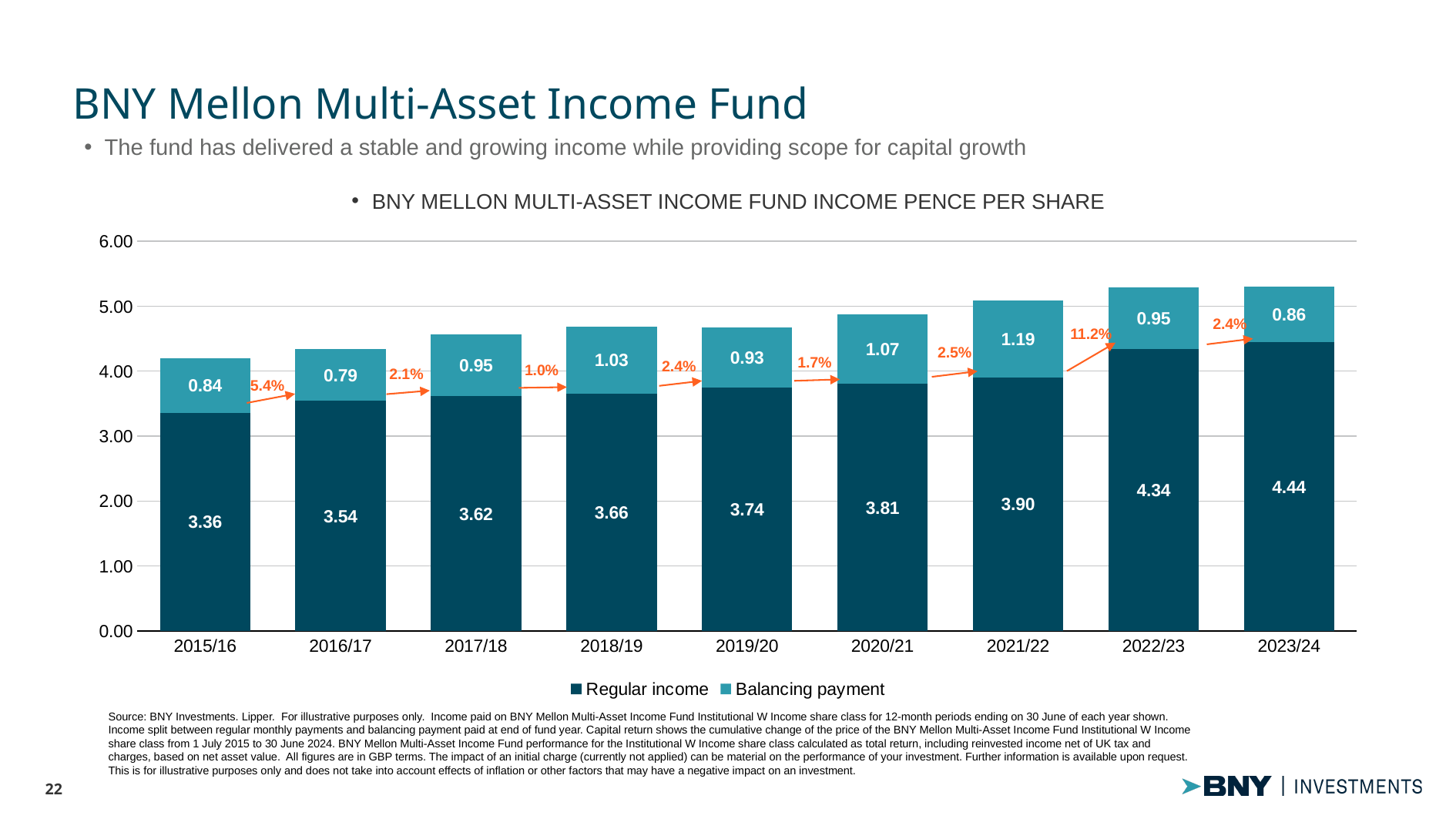
Which year has the highest Regular income? 2023/24 What is the Balancing payment value for 2021/22? 1.19 How many series does the legend list? 2 Is the total height of the 2015/16 bar greater or less than 4.00? greater What is the total income pence per share for 2023/24 (Regular income plus Balancing payment)? 5.30 What is the difference between the Regular income in 2023/24 and in 2015/16? 1.08 How many years are shown on the x axis? 9 Does the Regular income rise or fall from 2015/16 to 2023/24? Rise What kind of chart is shown on the slide? Stacked bar chart Which year has the lowest Balancing payment? 2016/17 What is the Regular income value for 2015/16? 3.36 Which is larger, the Balancing payment in 2018/19 or in 2019/20? 2018/19